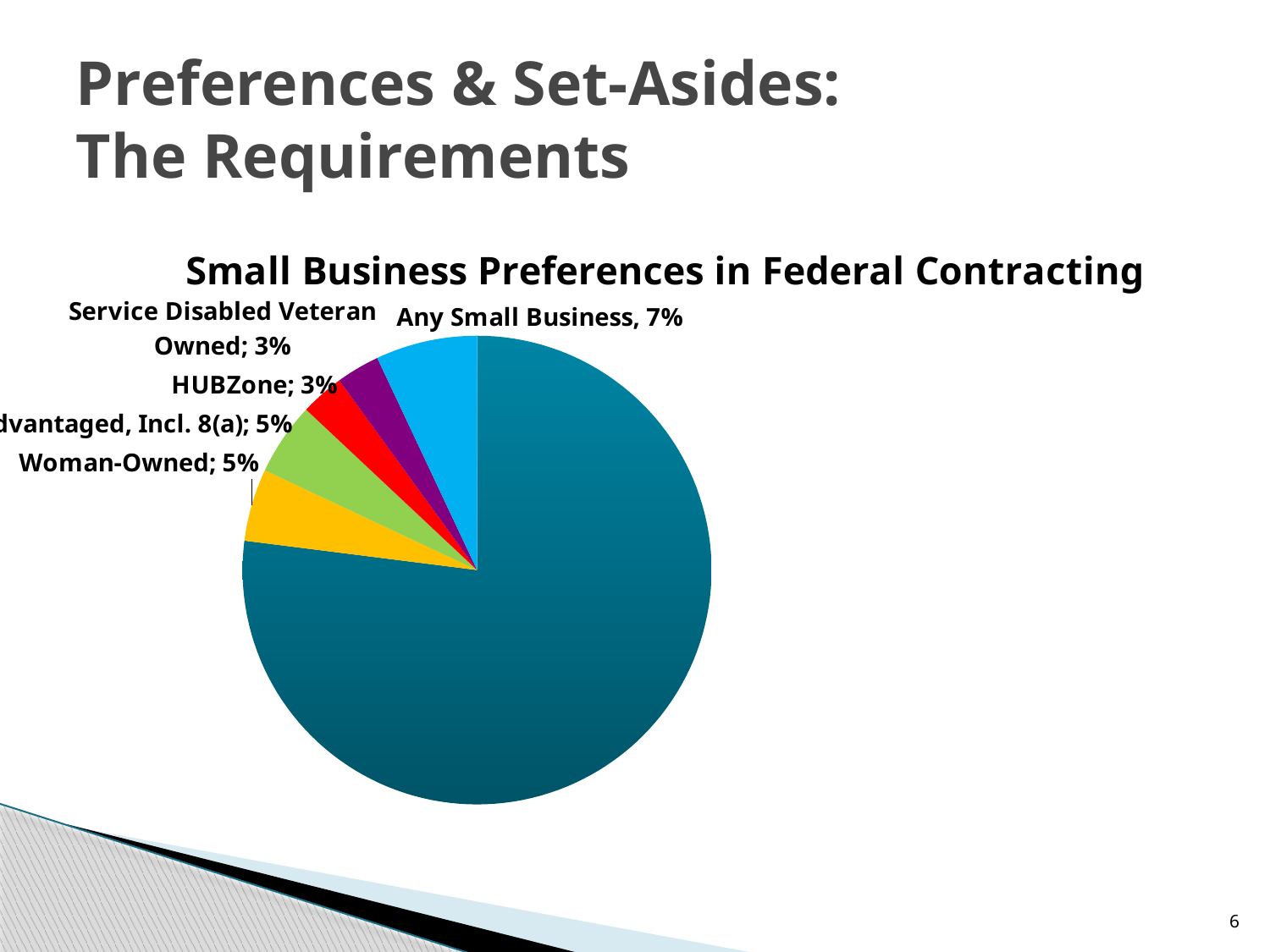
How many slices does the pie chart have? 6 Among the labelled slices, which has the largest percentage? Any Small Business What percentage is shown for HUBZone? 3% What is the difference between the Woman-Owned share and the Service Disabled Veteran Owned share? 2% What percentage is shown for Any Small Business? 7% What colour is the Any Small Business slice? Light blue What percentage is shown for Woman-Owned? 5% What kind of chart is shown on the slide? Pie chart What percentage is shown for Service Disabled Veteran Owned? 3% What is the difference between the Any Small Business share and the HUBZone share? 4% What is the title of the chart? Small Business Preferences in Federal Contracting Which is larger, the share for Any Small Business or the share for Woman-Owned? Any Small Business